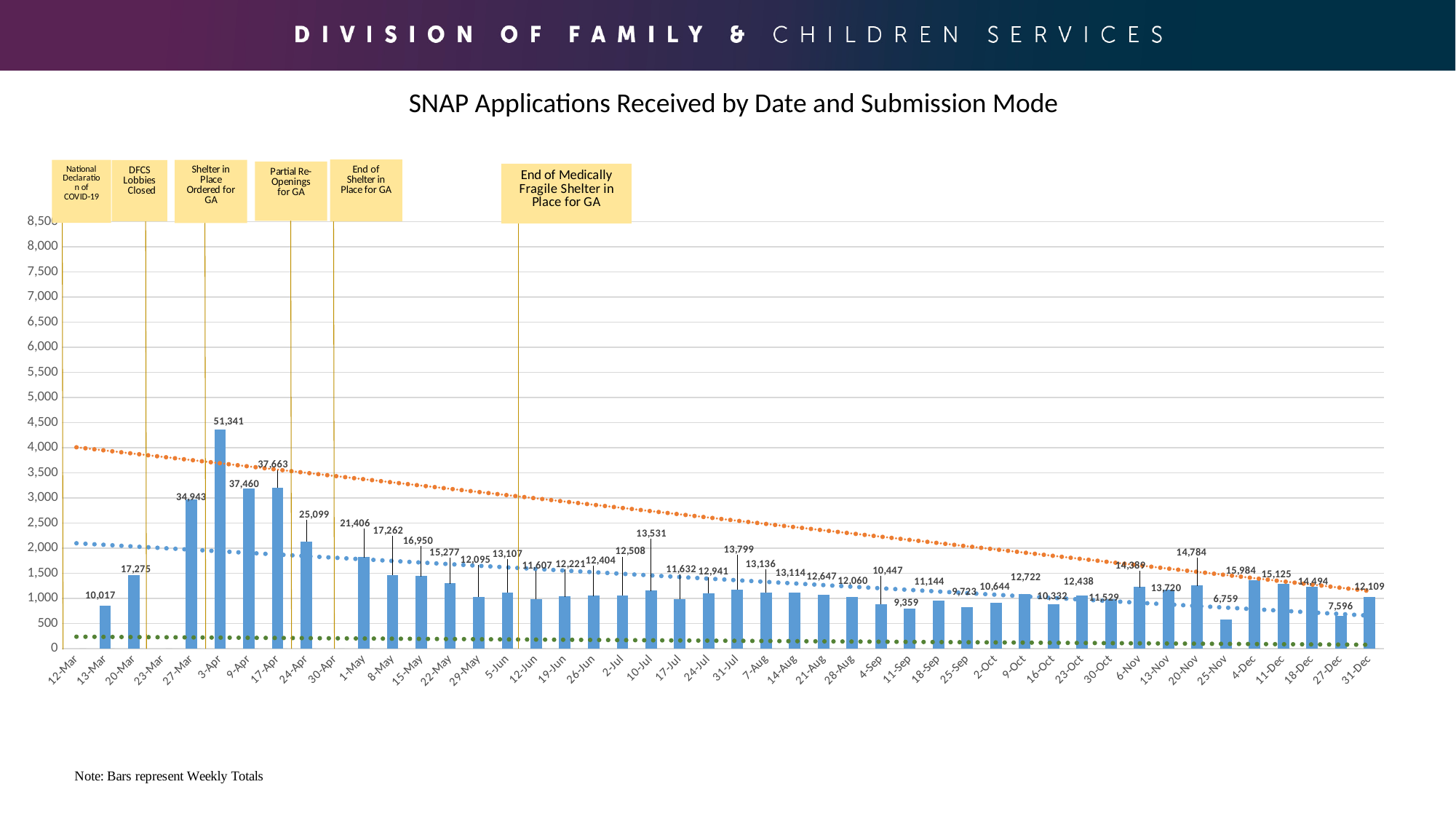
What is the title of the chart? SNAP Applications Received by Date and Submission Mode What is the labeled value for the week of 31-Dec? 12,109 What is the labeled value for the week of 13-Mar? 10,017 Does the orange dotted line rise or fall from left to right across the chart? fall What is the labeled value for the week of 25-Nov? 6,759 Which week has the highest labeled value? 3-Apr What is the difference between the labeled values for 20-Nov and 25-Nov? 8,025 Which week has the larger labeled value, 27-Mar or 24-Apr? 27-Mar What is the labeled value for the week of 3-Apr? 51,341 What type of chart is used to show the weekly totals? bar chart What is the difference between the labeled values for 3-Apr and 13-Mar? 41,324 Which week has the lowest labeled value? 25-Nov